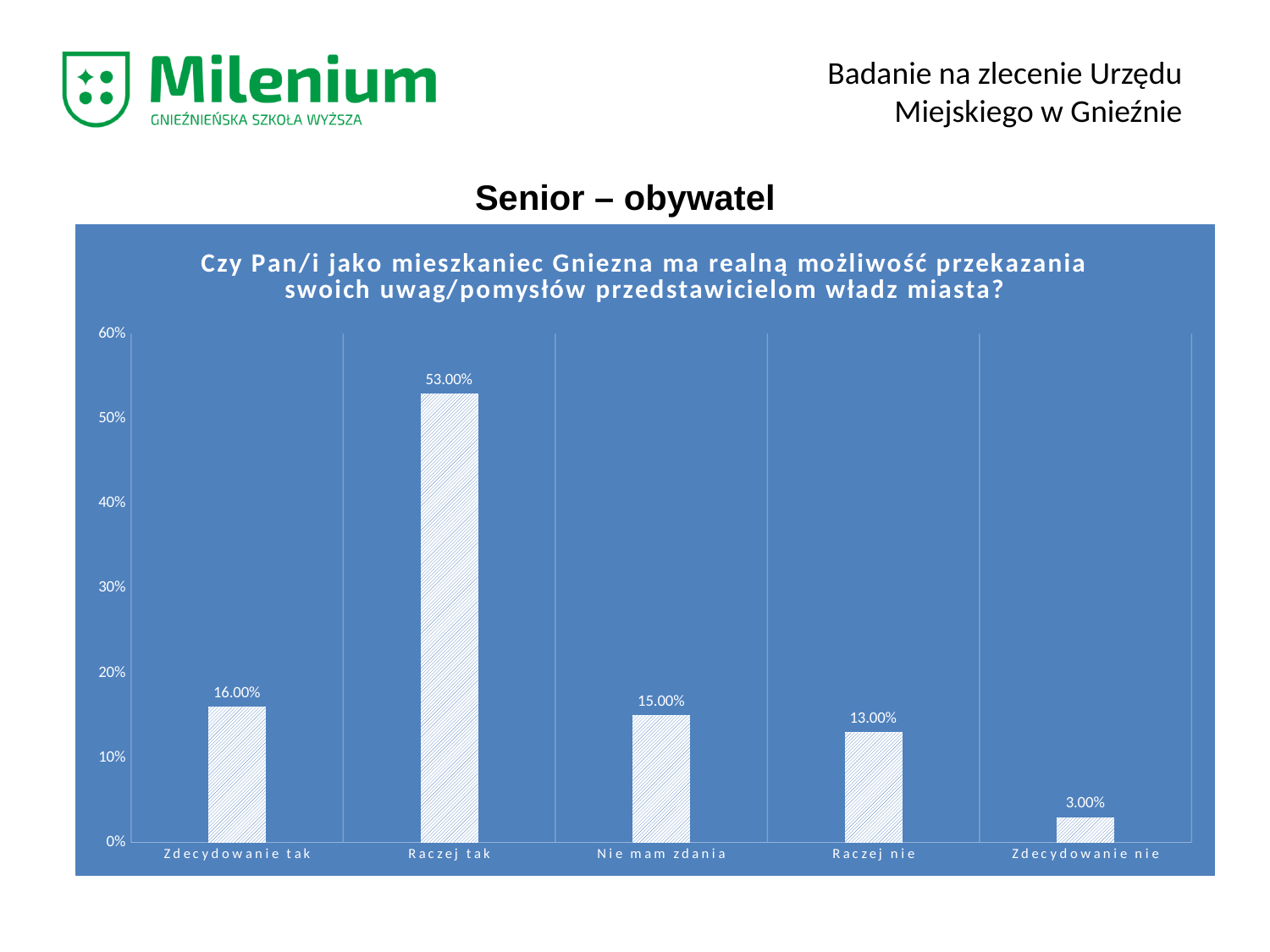
What kind of chart is shown on the slide? Bar chart What is the value for "Raczej tak"? 53.00% Is the value for "Raczej tak" greater or less than 50%? greater What is the value for "Zdecydowanie tak"? 16.00% What is the value for "Zdecydowanie nie"? 3.00% Which is larger, the value for "Zdecydowanie tak" or the value for "Raczej nie"? Zdecydowanie tak What is the difference between the values for "Raczej tak" and "Zdecydowanie tak"? 37.00% What is the difference between the values for "Raczej nie" and "Zdecydowanie nie"? 10.00% Which category has the lowest value? Zdecydowanie nie Which category has the highest value? Raczej tak How many categories are shown on the x axis? 5 What is the value for "Nie mam zdania"? 15.00%